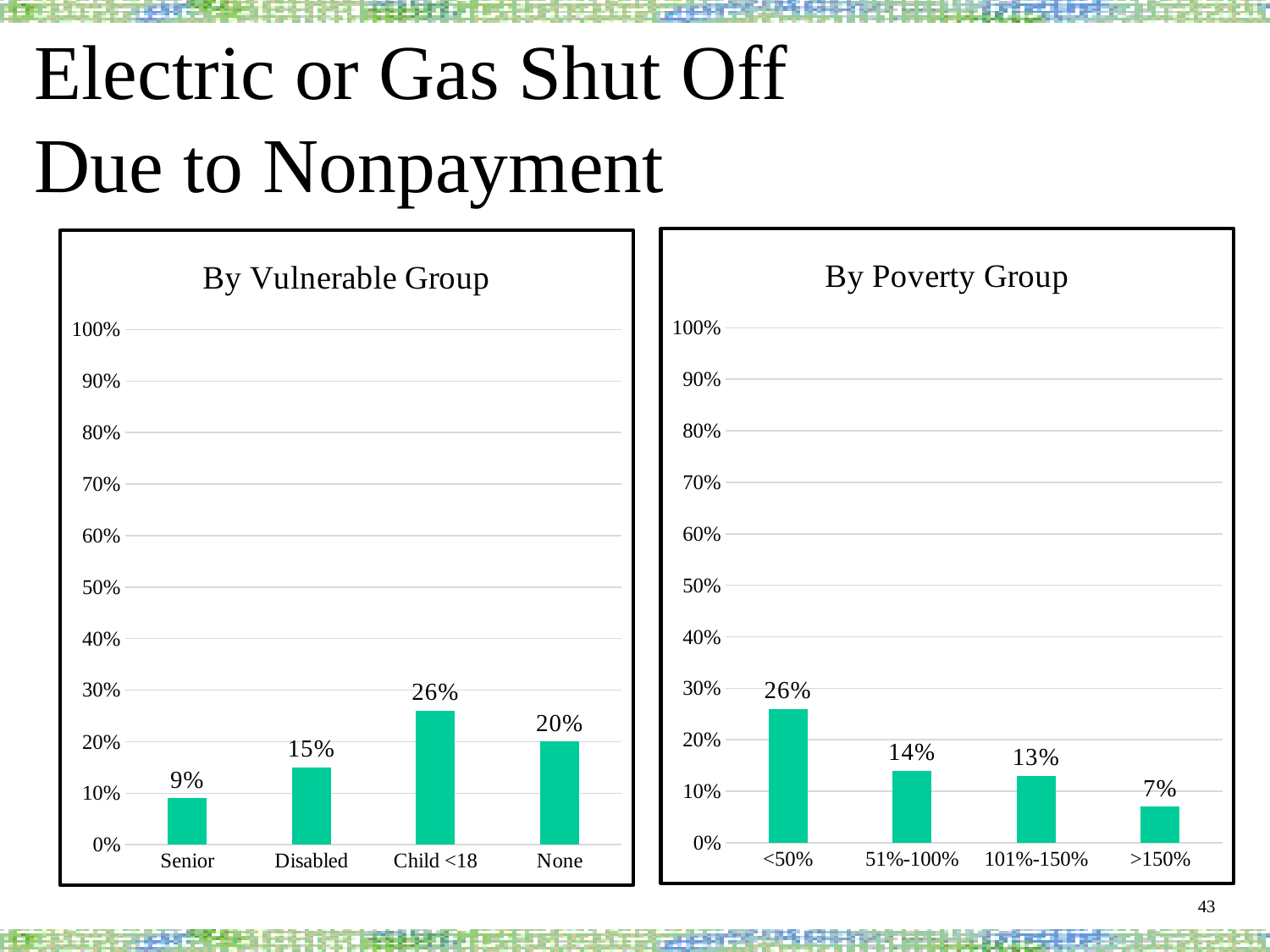
In the 'By Vulnerable Group' chart, what is the difference between the values for Child <18 and Disabled? 11% In the 'By Vulnerable Group' chart, what is the value for Senior? 9% In the 'By Vulnerable Group' chart, which category has the highest value? Child <18 In the 'By Poverty Group' chart, what is the value for >150%? 7% In the 'By Poverty Group' chart, do the values rise or fall from left to right along the x axis? fall In the 'By Vulnerable Group' chart, how many categories are shown? 4 In the 'By Vulnerable Group' chart, which category has the lowest value? Senior What kind of chart is the 'By Poverty Group' chart? bar chart In the 'By Poverty Group' chart, is the value for <50% larger or smaller than the value for 101%-150%? larger In the 'By Vulnerable Group' chart, what is the value for Child <18? 26% In the 'By Poverty Group' chart, which category has the highest value? <50% In the 'By Poverty Group' chart, what is the value for 51%-100%? 14%